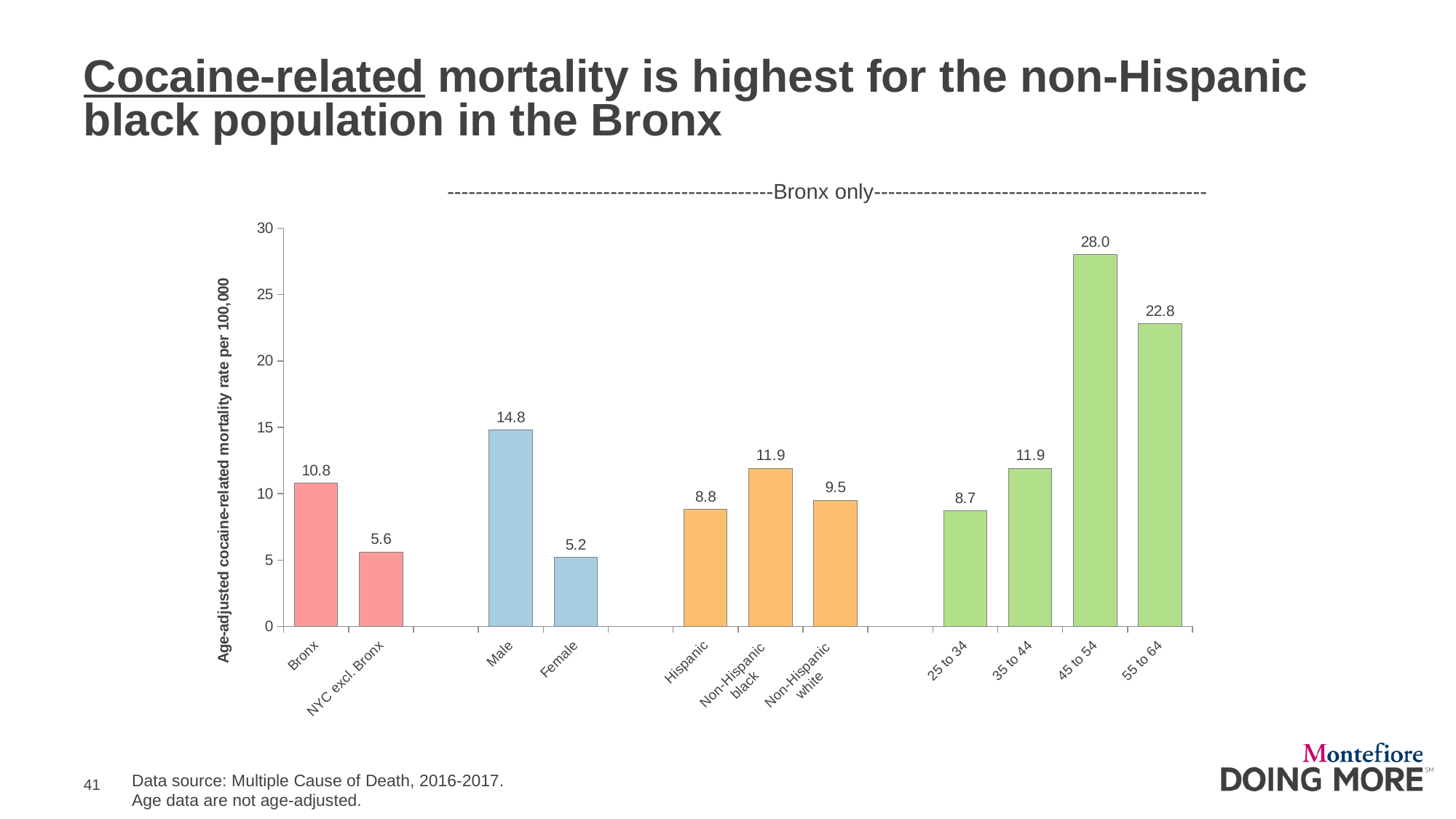
What is the cocaine-related mortality rate for the 45 to 54 age group? 28.0 What is the difference between the Bronx and NYC excl. Bronx cocaine-related mortality rates? 5.2 What is the difference between the Male and Female cocaine-related mortality rates? 9.6 Which has a higher cocaine-related mortality rate, Hispanic or Non-Hispanic black? Non-Hispanic black Which category has the highest cocaine-related mortality rate on the chart? 45 to 54 How many bars are plotted on the chart? 11 What is the age-adjusted cocaine-related mortality rate per 100,000 for the Bronx? 10.8 What kind of chart is shown on the slide? Bar chart What is the cocaine-related mortality rate for Non-Hispanic white? 9.5 What is the label of the vertical axis? Age-adjusted cocaine-related mortality rate per 100,000 Which category has the lowest cocaine-related mortality rate on the chart? Female What is the cocaine-related mortality rate for NYC excl. Bronx? 5.6